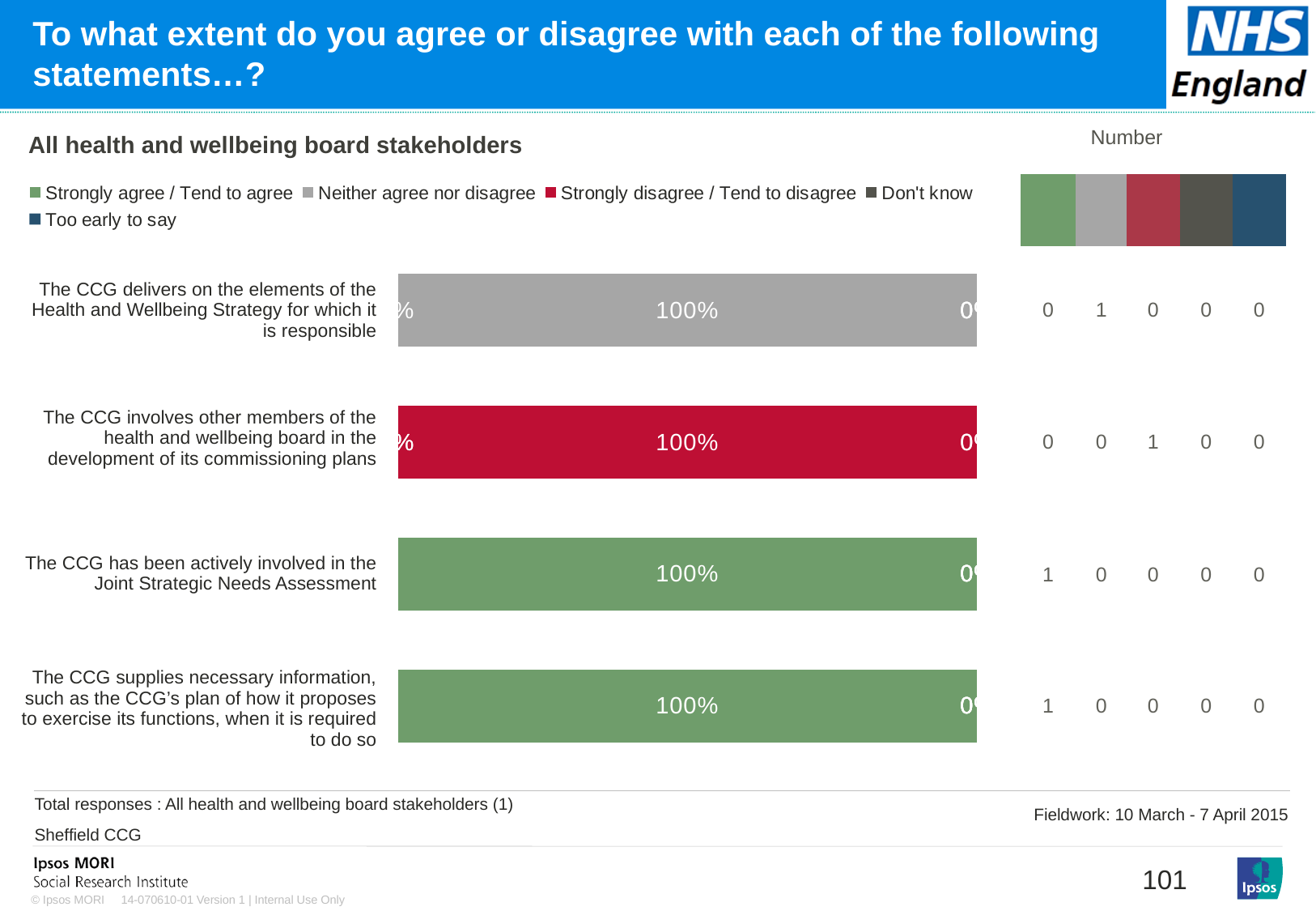
What percentage is shown for 'Strongly agree / Tend to agree' for the statement 'The CCG supplies necessary information, such as the CCG's plan of how it proposes to exercise its functions, when it is required to do so'? 100% What percentage is shown for 'Strongly disagree / Tend to disagree' for the statement 'The CCG involves other members of the health and wellbeing board in the development of its commissioning plans'? 100% What percentage is shown for 'Neither agree nor disagree' for the statement 'The CCG delivers on the elements of the Health and Wellbeing Strategy for which it is responsible'? 100% What kind of chart is shown on the slide? bar chart In the Number table, how many respondents answered 'Strongly disagree / Tend to disagree' for the statement 'The CCG involves other members of the health and wellbeing board in the development of its commissioning plans'? 1 Which series is shown in green in the legend? Strongly agree / Tend to agree Which series is shown in red in the legend? Strongly disagree / Tend to disagree How many series does the legend list? 5 How many statements (categories) are plotted in the chart? 4 What percentage is shown for 'Strongly agree / Tend to agree' for the statement 'The CCG has been actively involved in the Joint Strategic Needs Assessment'? 100% In the Number table, how many respondents answered 'Neither agree nor disagree' for the statement 'The CCG delivers on the elements of the Health and Wellbeing Strategy for which it is responsible'? 1 How many statements have 100% in the 'Strongly agree / Tend to agree' category? 2